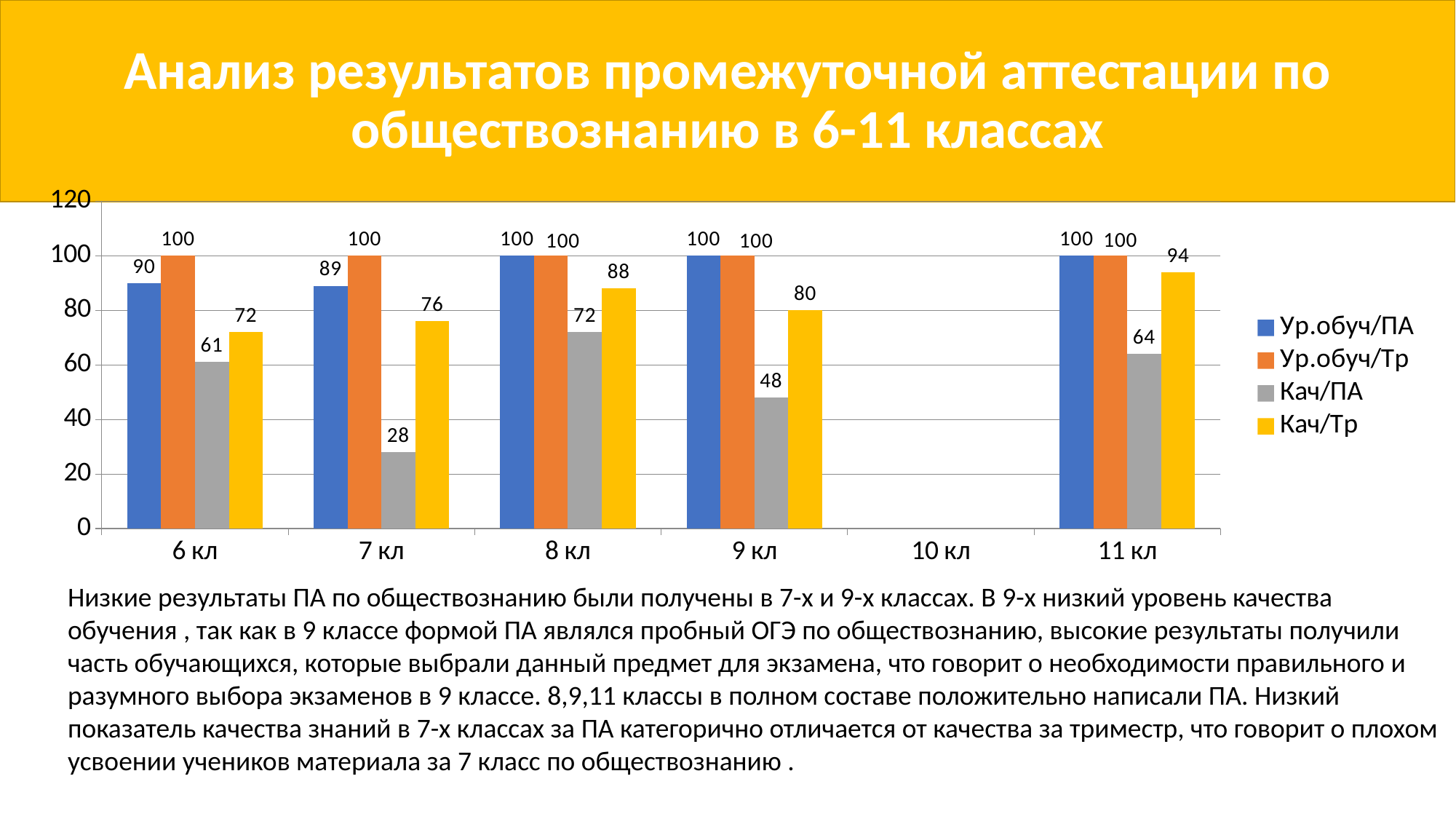
What is the value of Ур.обуч/ПА for 6 кл? 90 Which class has the highest Кач/Тр value? 11 кл Which class has the lowest Кач/ПА value? 7 кл How many series does the legend list? 4 How many class categories are shown on the x axis? 6 What is the value of Кач/Тр for 11 кл? 94 What is the value of Кач/ПА for 7 кл? 28 Which is larger for 8 кл: Кач/ПА or Кач/Тр? Кач/Тр What kind of chart is shown on the slide? Bar chart Which class category has no bars plotted? 10 кл What colour are the Кач/Тр bars? Yellow What is the difference between Кач/Тр and Кач/ПА for 9 кл? 32